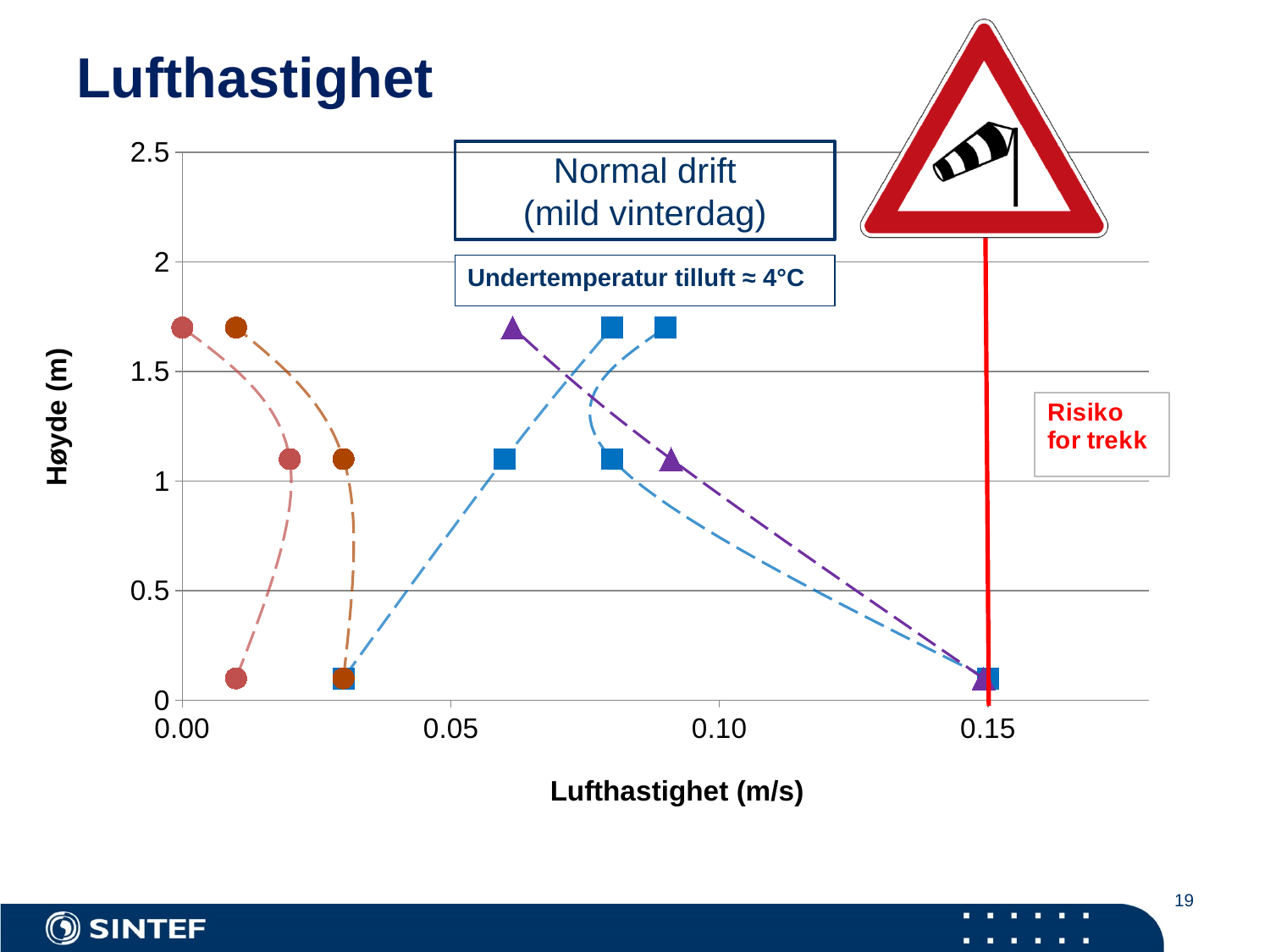
What kind of chart is shown on the slide? Scatter chart with dashed lines Which series reaches the larger air velocity at its lowest point: the orange circle series or the blue square series? The blue square series Is the air velocity of the highest pink circle point greater or less than 0.05? less Is the height of the lowest row of data points greater or less than 0.5? less What is the title of the chart's x axis? Lufthastighet (m/s) At what air velocity (x value) is the red vertical 'Risiko for trekk' line drawn? 0.15 How many data points does the purple triangle series have? 3 Is the height of the topmost row of data points greater or less than 1.5? greater What is the title of the chart's y axis? Høyde (m) Along the x axis, do the circle series lie to the left or to the right of the square and triangle series? To the left What is the highest value shown on the y axis? 2.5